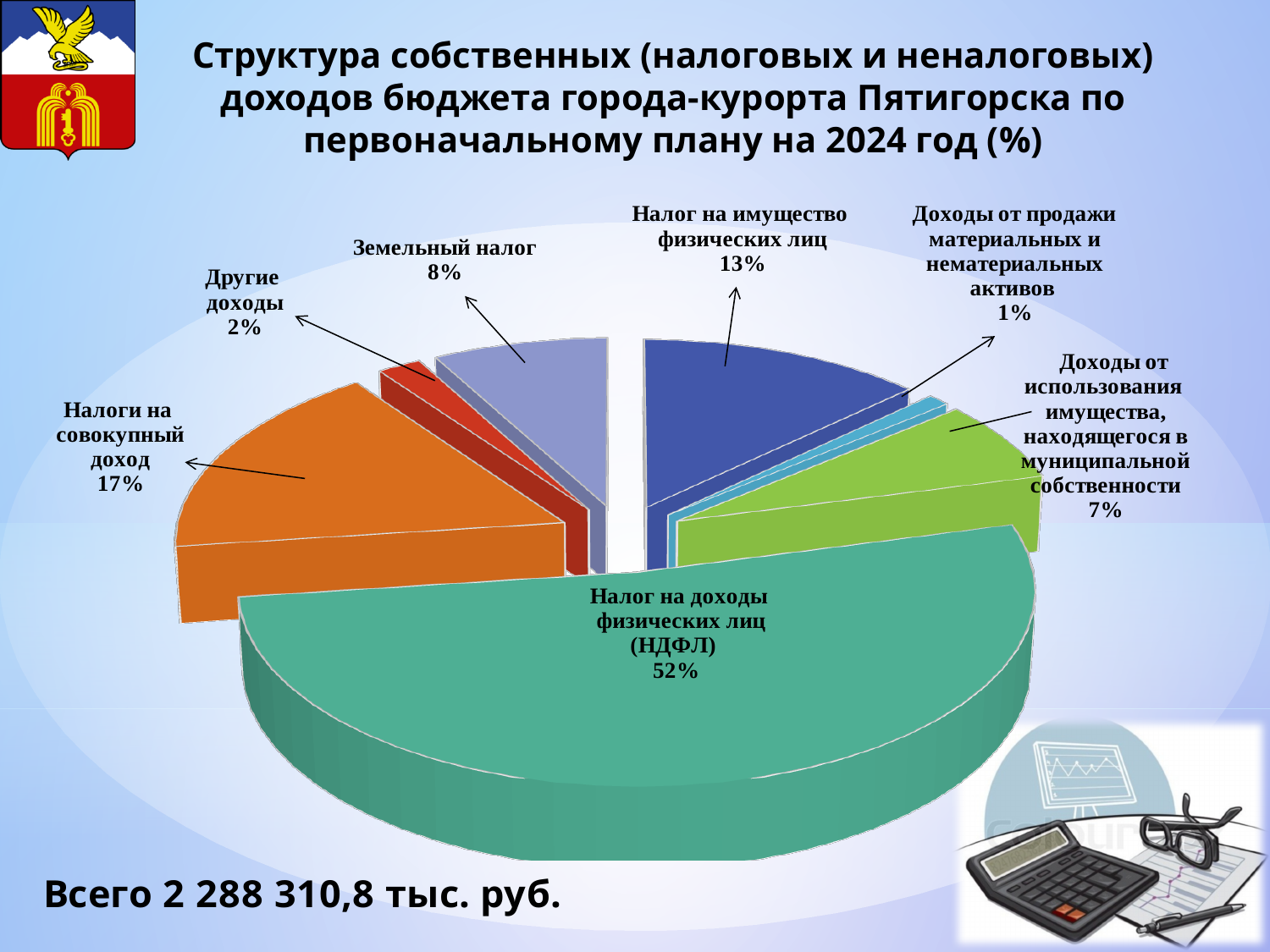
Which is larger: the share for Налог на имущество физических лиц or the share for Другие доходы? Налог на имущество физических лиц What is the share for Земельный налог? 8% What is the share for Налоги на совокупный доход? 17% What is the difference in percentage points between Налоги на совокупный доход and Земельный налог? 9 What is the share for Налог на имущество физических лиц? 13% What is the share for Доходы от использования имущества, находящегося в муниципальной собственности? 7% Which category has the smallest share of the pie? Доходы от продажи материальных и нематериальных активов Which category has the largest share of the pie? Налог на доходы физических лиц (НДФЛ) What share of the budget's own revenues does НДФЛ (Налог на доходы физических лиц) account for? 52% How many slices does the pie chart have? 7 What kind of chart is shown on the slide? Pie chart What total amount of own revenues is stated at the bottom of the slide? 2 288 310,8 тыс. руб.